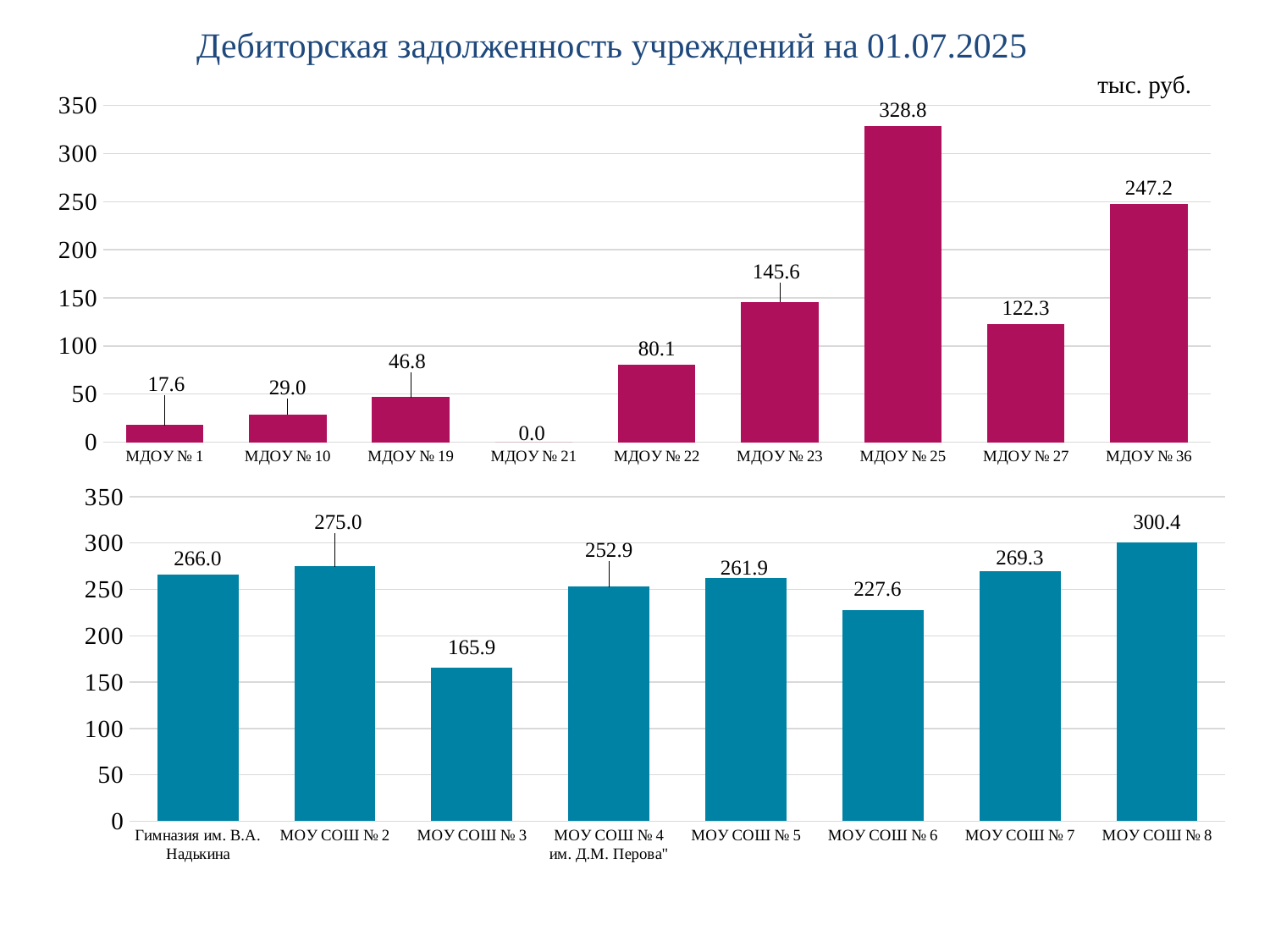
In the top chart, what is the difference between the values for МДОУ № 36 and МДОУ № 27? 124.9 What type of chart is the bottom chart? Bar chart In the bottom chart, what is the value for МОУ СОШ № 6? 227.6 In the top chart, which category has the highest value? МДОУ № 25 In the top chart, what is the value for МДОУ № 25? 328.8 In the bottom chart, which category has the lowest value? МОУ СОШ № 3 In the top chart, which category has the lowest value? МДОУ № 21 What is the title of the slide's charts? Дебиторская задолженность учреждений на 01.07.2025 In the bottom chart, which is larger: the value for МОУ СОШ № 2 or the value for МОУ СОШ № 7? МОУ СОШ № 2 How many categories are shown in the bottom chart? 8 In the bottom chart, which category has the highest value? МОУ СОШ № 8 How many categories are shown in the top chart? 9